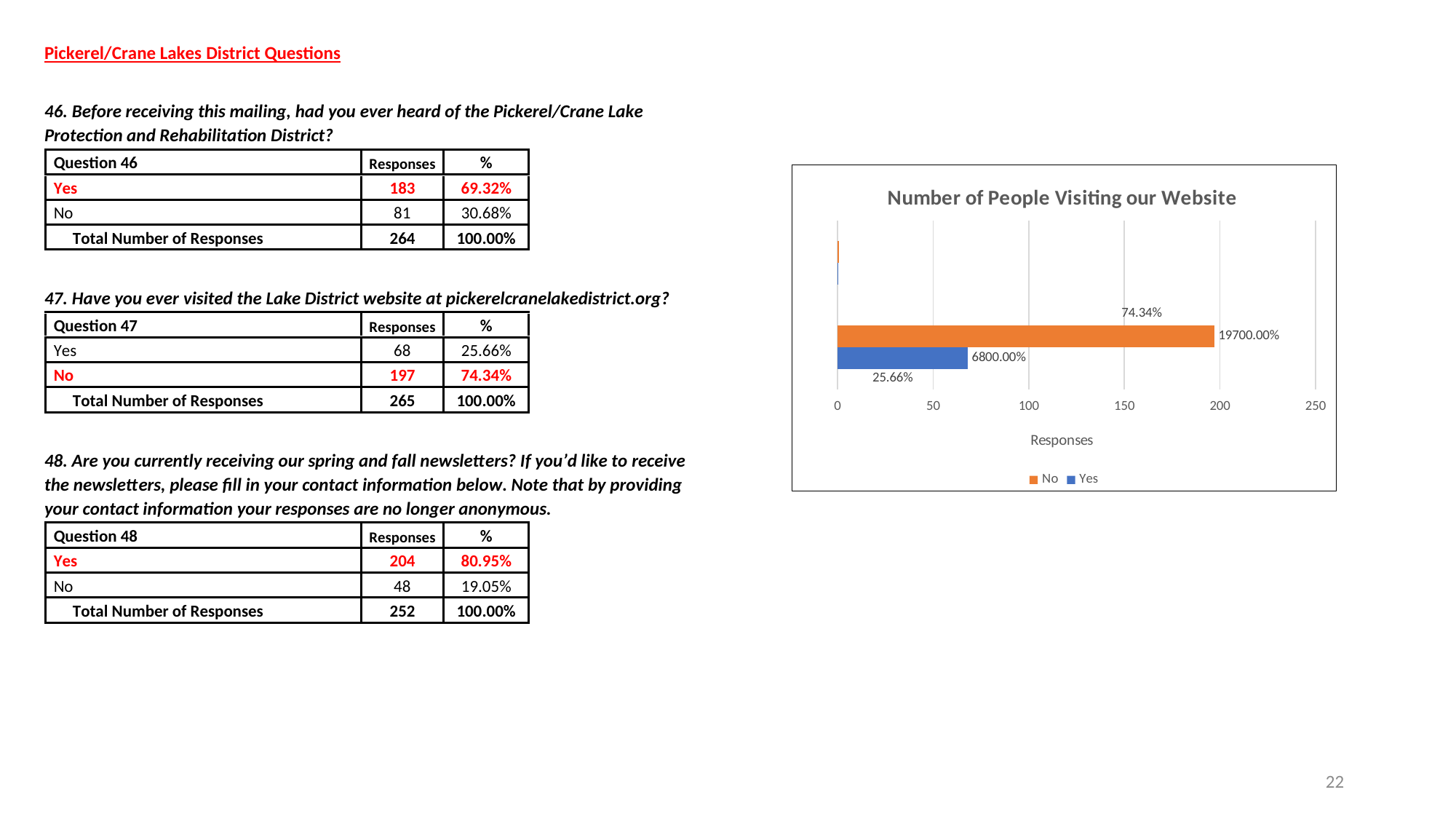
What kind of chart is shown on the slide? bar chart What is the title of the chart? Number of People Visiting our Website What data label is printed at the end of the orange No bar in the chart? 19700.00% Is the Yes bar in the chart greater or less than 100 on the Responses axis? less What percentage label is shown below the Yes bar in the chart? 25.66% How many series does the chart legend list? 2 Which series in the chart has the shortest bar? Yes What percentage label is shown above the No bar in the chart? 74.34% Which series in the chart has the longer bar, No or Yes? No Is the No bar in the chart greater or less than 150 on the Responses axis? greater What is the label of the horizontal axis in the chart? Responses What data label is printed at the end of the blue Yes bar in the chart? 6800.00%